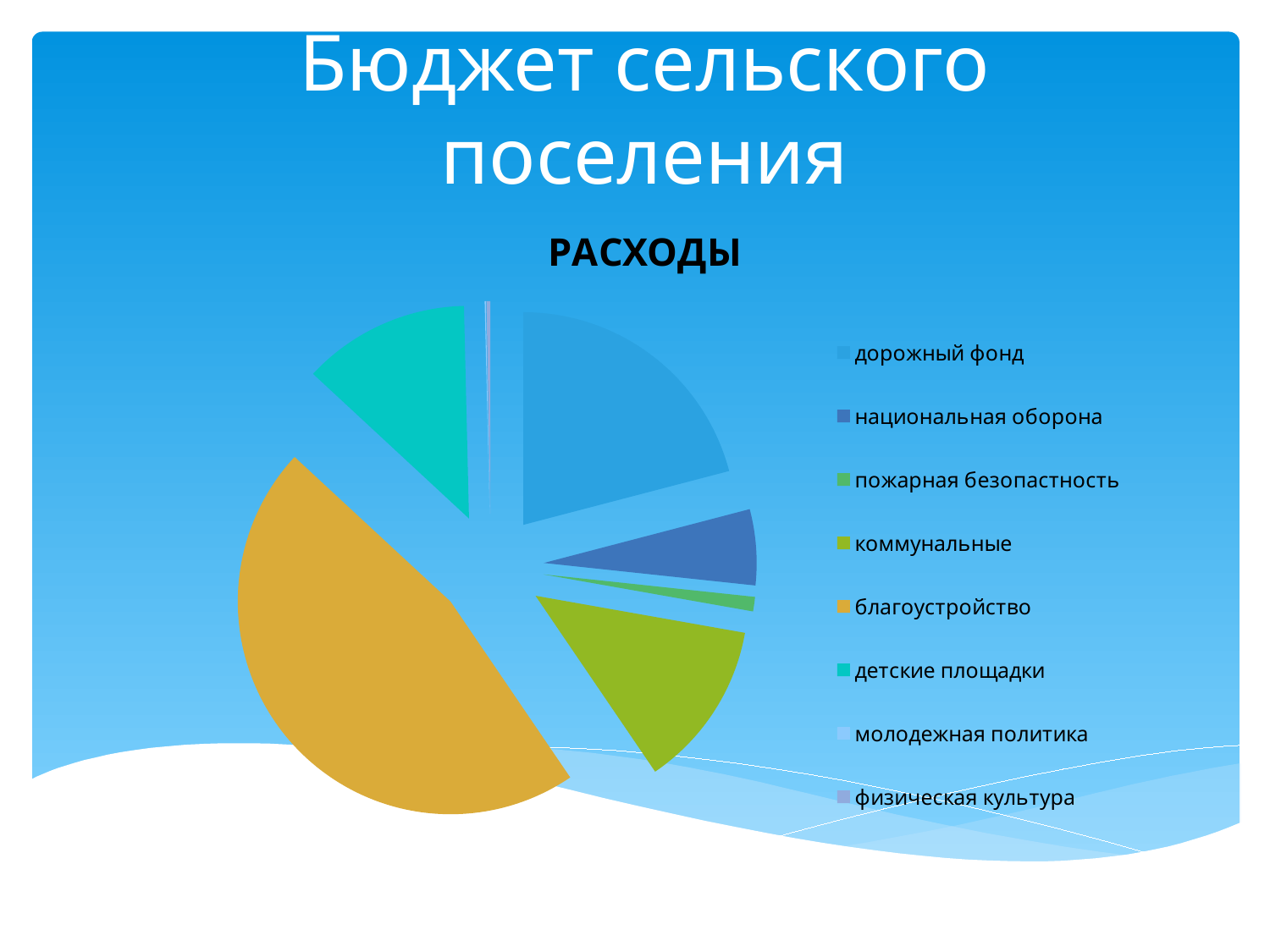
What is the title of the chart? РАСХОДЫ Which slice is larger, дорожный фонд or коммунальные? дорожный фонд Which slice is larger, коммунальные or пожарная безопастность? коммунальные How many categories does the legend of the pie chart list? 8 Which category is shown in orange on the pie chart? благоустройство What kind of chart is shown on the slide? pie chart How many slices does the pie chart have according to the legend? 8 Which category has the largest slice of the pie chart? благоустройство Which slice is larger, национальная оборона or пожарная безопастность? национальная оборона